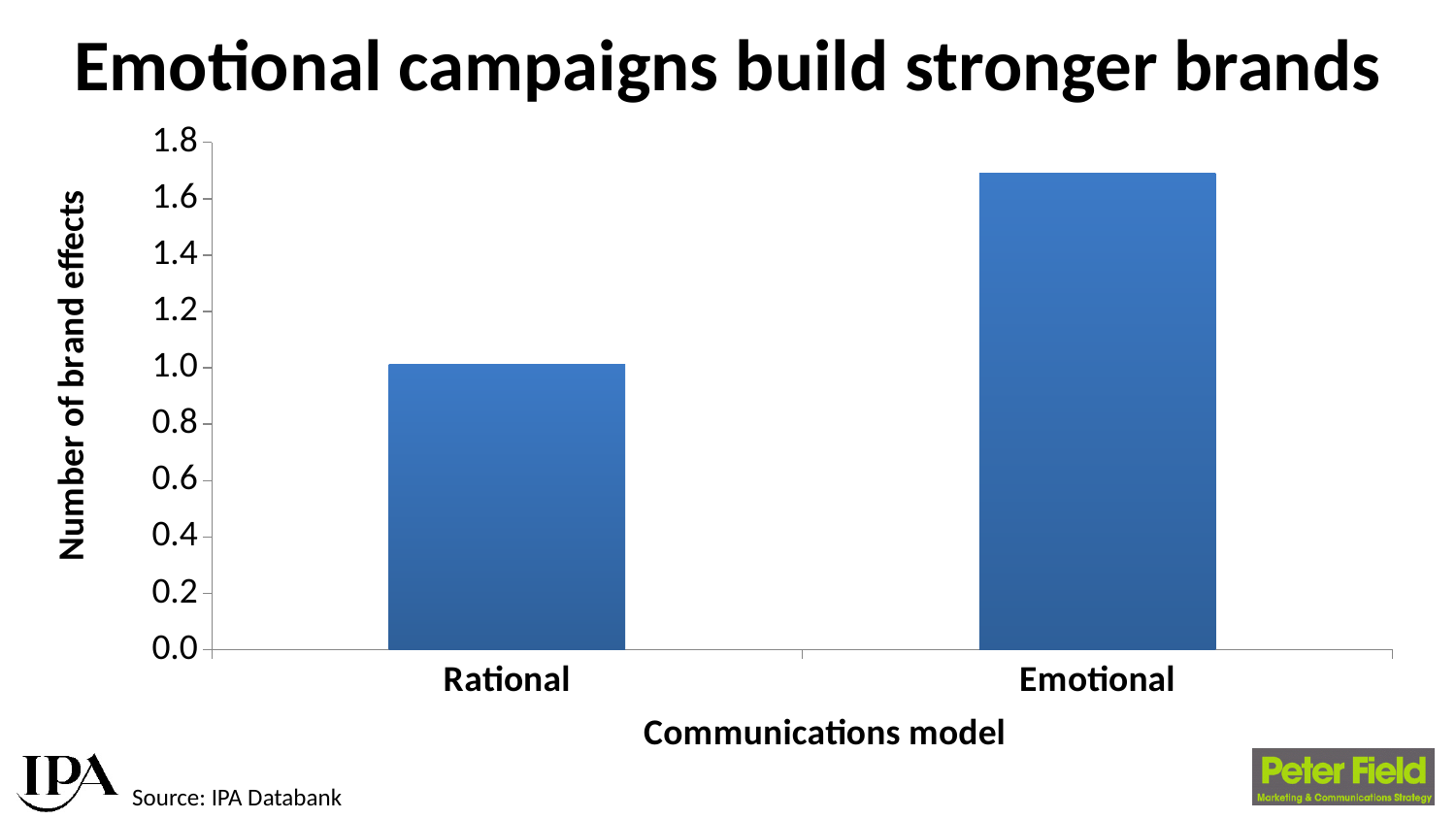
Which communications model has the higher number of brand effects? Emotional Is the value for Emotional greater or less than 1.6? greater Which is larger, the value for Rational or the value for Emotional? Emotional What kind of chart is shown on the slide? bar chart Is the value for Rational greater or less than 1.2? less Is the value for Emotional greater or less than 1.8? less How many categories are plotted on the x axis? 2 What is the title of the slide? Emotional campaigns build stronger brands Which communications model has the lower number of brand effects? Rational What is the label on the y axis of the chart? Number of brand effects